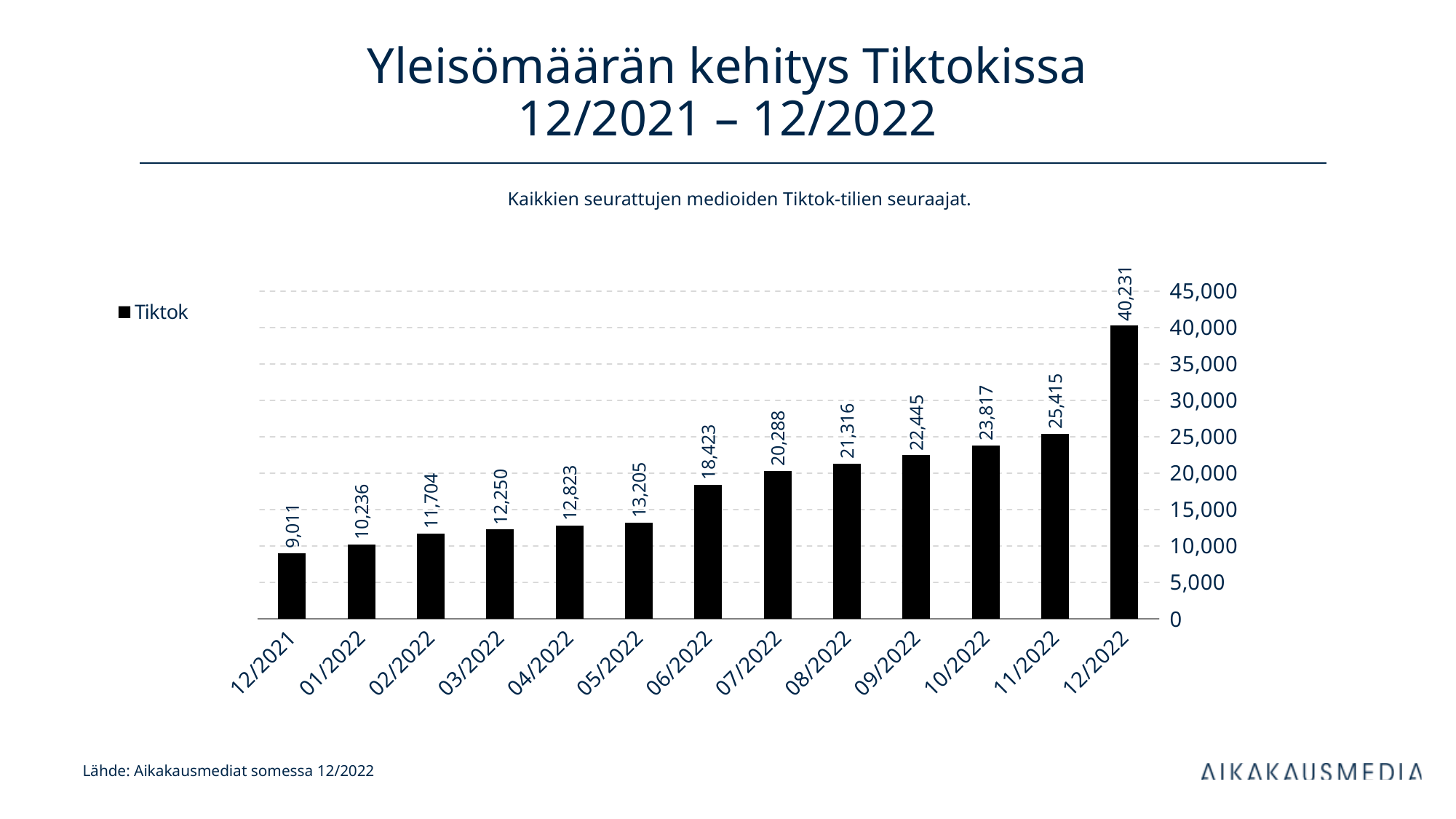
What is the value for 06/2022? 18,423 What is the value for 12/2022? 40,231 What is the difference between the values for 12/2022 and 12/2021? 31,220 What kind of chart is shown on the slide? bar chart Which month has the highest value? 12/2022 Which month has the lowest value? 12/2021 Do the values rise or fall from 12/2021 to 12/2022? rise Which is larger, the value for 09/2022 or the value for 05/2022? 09/2022 What is the value for 12/2021? 9,011 How many months are shown on the x axis? 13 Is the value for 10/2022 greater or less than 20,000? greater What is the difference between the values for 12/2022 and 11/2022? 14,816